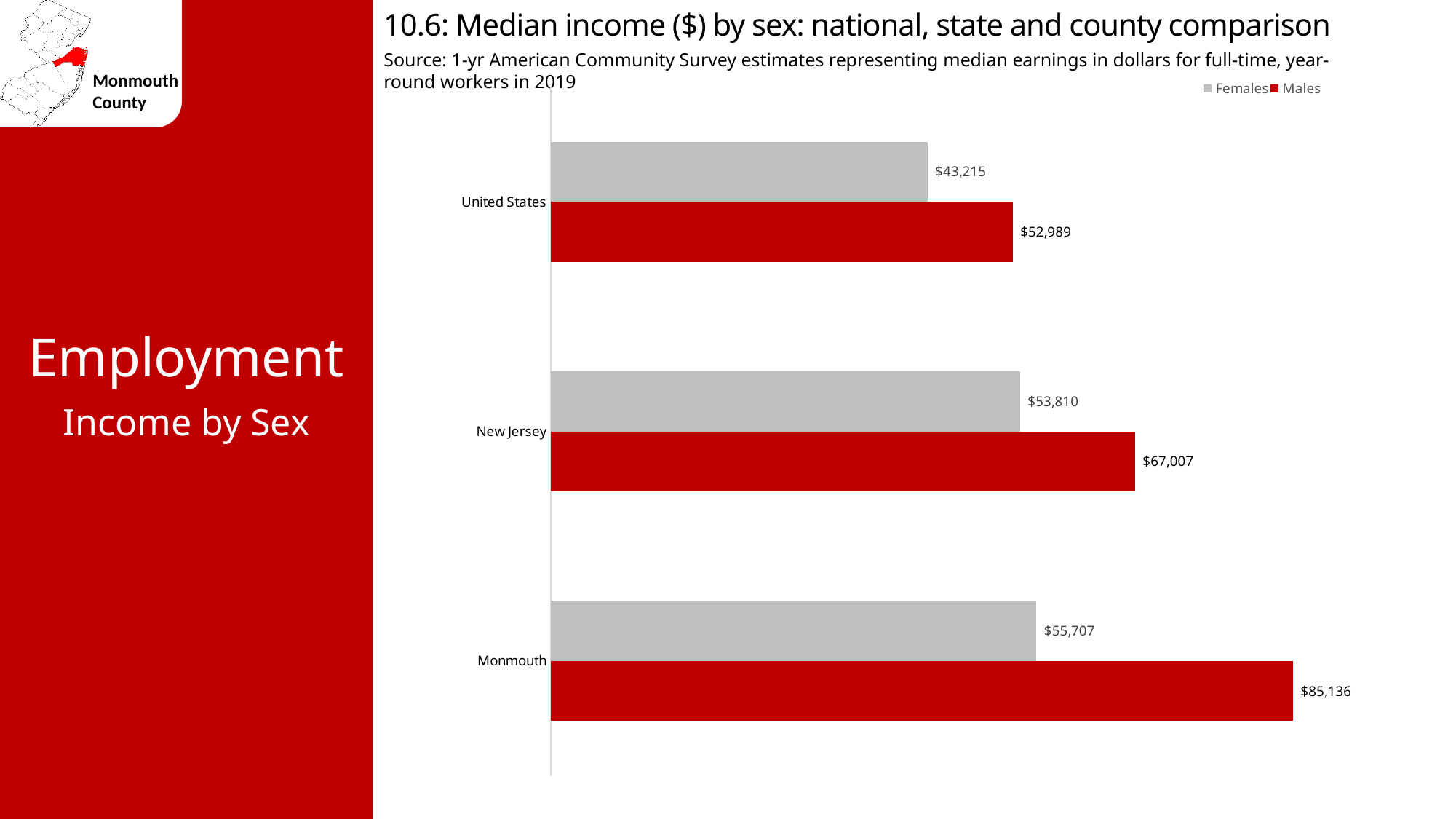
What is the median income for females in the United States? $43,215 What is the median income for males in the United States? $52,989 How many geographies are shown on the chart? 3 Which is larger: the median income for females in Monmouth or for males in the United States? Females in Monmouth How many series does the legend list? 2 What is the median income for females in New Jersey? $53,810 Which geography has the highest median income for males? Monmouth What is the median income for males in Monmouth? $85,136 What is the difference between male and female median income in Monmouth? $29,429 What is the difference between male and female median income in New Jersey? $13,197 What type of chart is shown on the slide? Bar chart Which geography has the lowest median income for females? United States